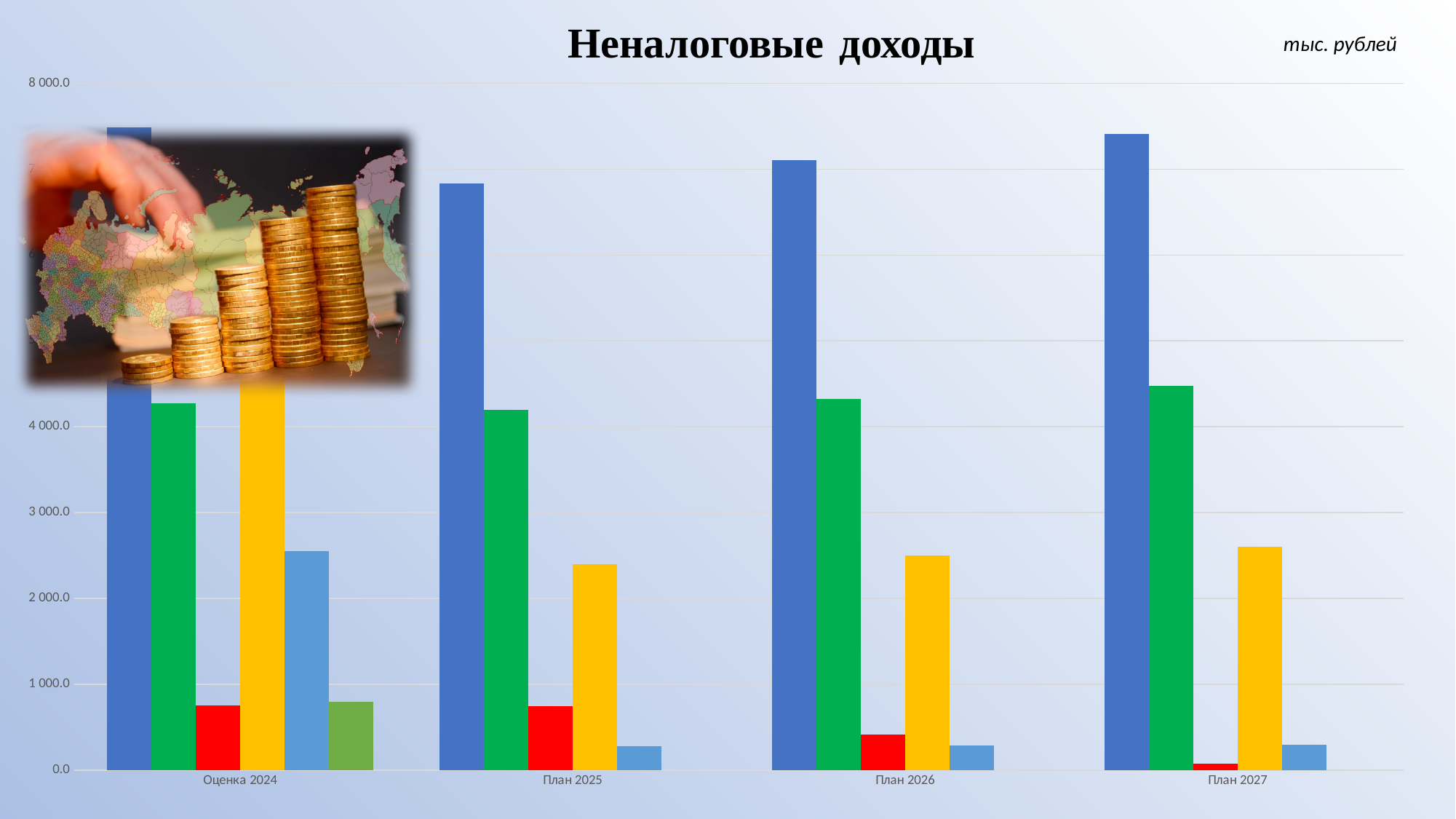
Which is larger in the План 2026 group: the dark blue bar or the green bar? the dark blue bar Is the value of the red bar for План 2027 greater or less than 1 000.0? less What is the title of the chart? Неналоговые доходы What kind of chart is shown on the slide? bar chart Is the value of the green bar for План 2027 greater or less than 4 000.0? greater Is the value of the dark blue bar for План 2025 greater or less than 6 000.0? greater How many bars are in the Оценка 2024 group? 6 How many categories are shown on the x axis of the chart? 4 What unit is indicated for the values in the chart? тыс. рублей Which category has the shortest red bar? План 2027 Which category has the tallest yellow bar? Оценка 2024